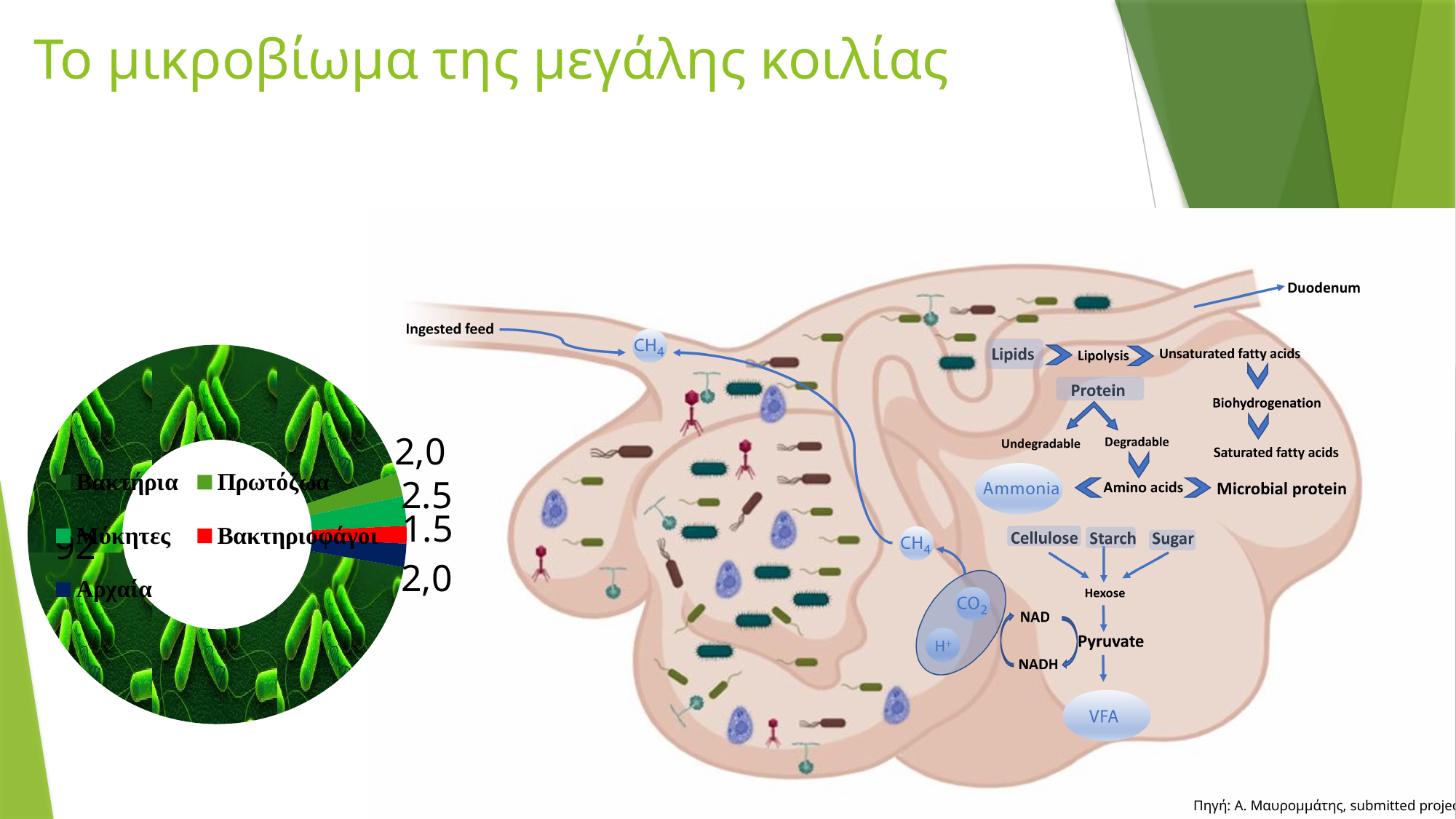
In the doughnut chart, what is the value for Βακτήρια? 92 What type of chart is shown on the left of the slide? Doughnut (pie) chart What share of the doughnut chart does Βακτήρια represent? 92% What colour is the Βακτηριοφάγοι slice in the doughnut chart? Red Which category has the smallest slice in the doughnut chart? Βακτηριοφάγοι How many categories does the doughnut chart's legend list? 5 In the doughnut chart, what is the value for Αρχαία? 2,0 In the doughnut chart, what is the value for Βακτηριοφάγοι? 1.5 In the doughnut chart, which is larger: the value for Αρχαία or the value for Βακτηριοφάγοι? Αρχαία What is the total of all the values shown in the doughnut chart? 100 Which category has the largest slice in the doughnut chart? Βακτήρια What is the difference between the values for Βακτήρια and Βακτηριοφάγοι in the doughnut chart? 90.5